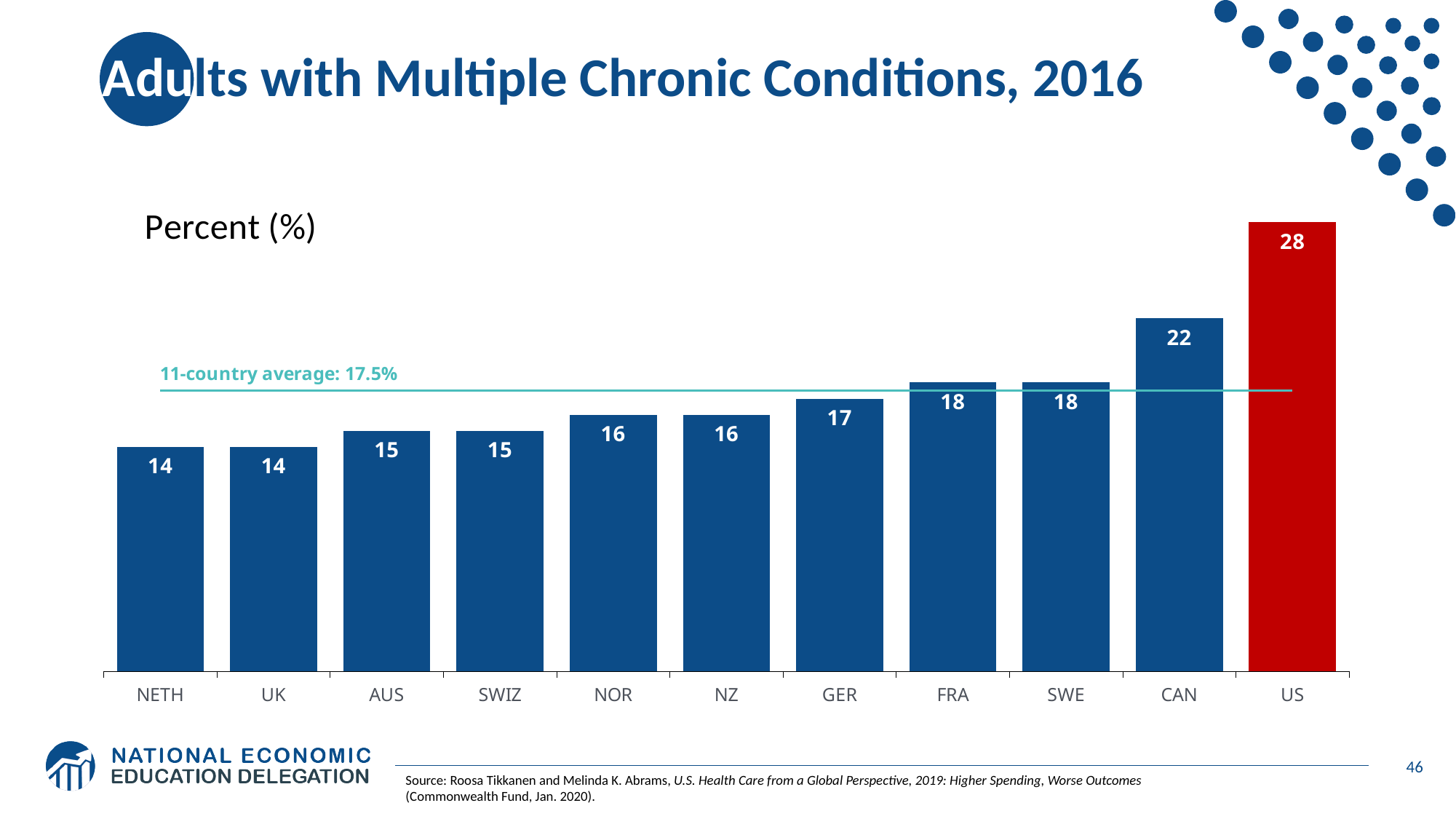
How many countries are shown on the chart? 11 Do the values rise or fall moving from left to right along the x axis? rise What kind of chart is shown on the slide? bar chart Which country has the highest value? US What is the difference between the values for the US and CAN? 6 What is the 11-country average shown on the chart? 17.5% What is the difference between the values for FRA and NETH? 4 What is the value for CAN? 22 Which bar is coloured red rather than blue? US Which is larger, the value for NOR or the value for SWE? SWE What is the value for GER? 17 What is the value for the US? 28